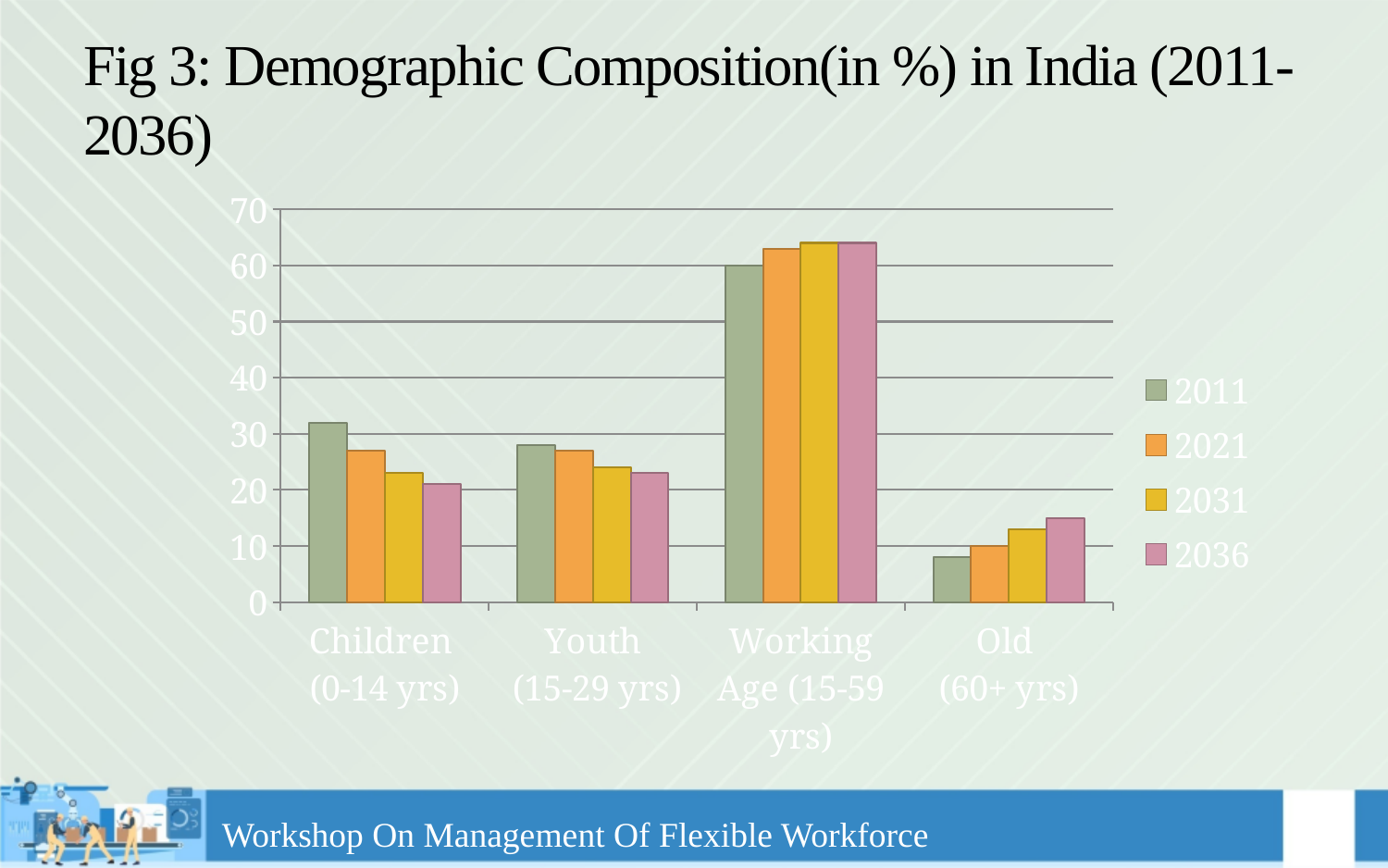
What kind of chart is shown on the slide? bar chart Is the value for Working Age (15-59 yrs) in 2036 greater or less than 60? greater Which age group has the lowest values across all years? Old (60+ yrs) Is the value for Youth (15-29 yrs) in 2036 greater or less than 30? less Which is larger for Children (0-14 yrs): the 2011 value or the 2036 value? 2011 How many age-group categories are shown on the x axis? 4 Which age group has the highest values across all years? Working Age (15-59 yrs) Is the value for Old (60+ yrs) in 2011 greater or less than 10? less Do the values for Old (60+ yrs) rise or fall from 2011 to 2036? rise How many series does the legend list? 4 Which year does the pink series in the legend represent? 2036